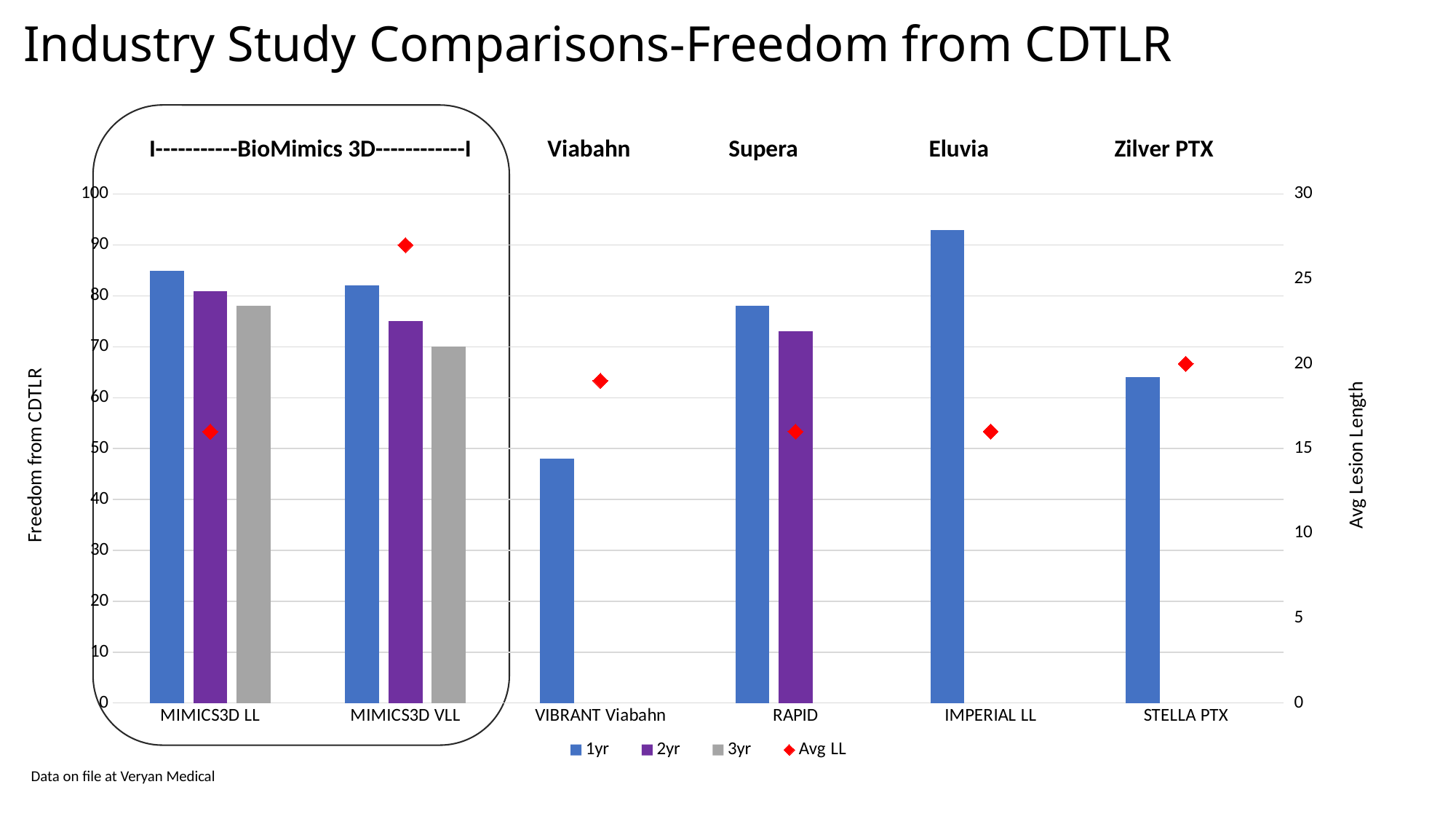
How many categories are shown along the x axis? 6 Is the 1yr value for IMPERIAL LL greater or less than 90? greater Which is larger, the 2yr value for MIMICS3D LL or the 2yr value for RAPID? MIMICS3D LL Which category has the lowest 1yr value? VIBRANT Viabahn Which category has the highest Avg LL marker? MIMICS3D VLL How many series does the legend list? 4 What kind of chart is shown on the slide? bar chart Is the 1yr value for STELLA PTX greater or less than 60? greater What is the title of the right-hand vertical axis? Avg Lesion Length Which is larger, the 1yr value for RAPID or the 1yr value for STELLA PTX? RAPID Which category has the highest 1yr value? IMPERIAL LL Is the 1yr value for VIBRANT Viabahn greater or less than 50? less